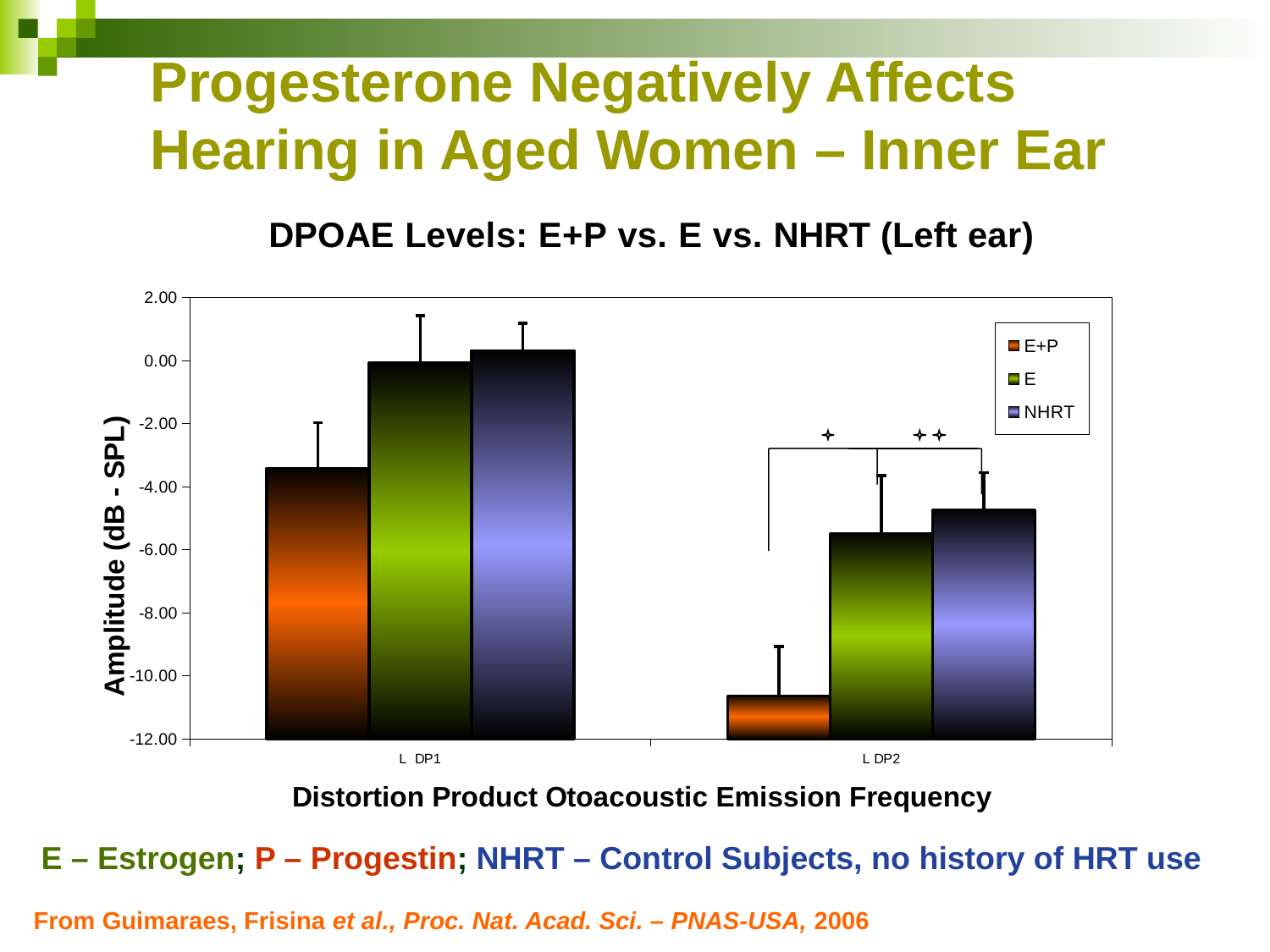
How many categories are shown on the x axis? 2 What is the label of the y axis? Amplitude (dB - SPL) At L DP2, which is larger, the value for E+P or the value for E? E Which series has the lowest value at L DP1? E+P Is the value for NHRT at L DP2 greater or less than -6.00? greater Which series has the lowest value at L DP2? E+P Is the value for E at L DP2 greater or less than -4.00? less What kind of chart is shown on the slide? bar chart Is the value for E+P at L DP1 greater or less than -2.00? less Does the value for E+P rise or fall from L DP1 to L DP2? fall How many series does the legend list? 3